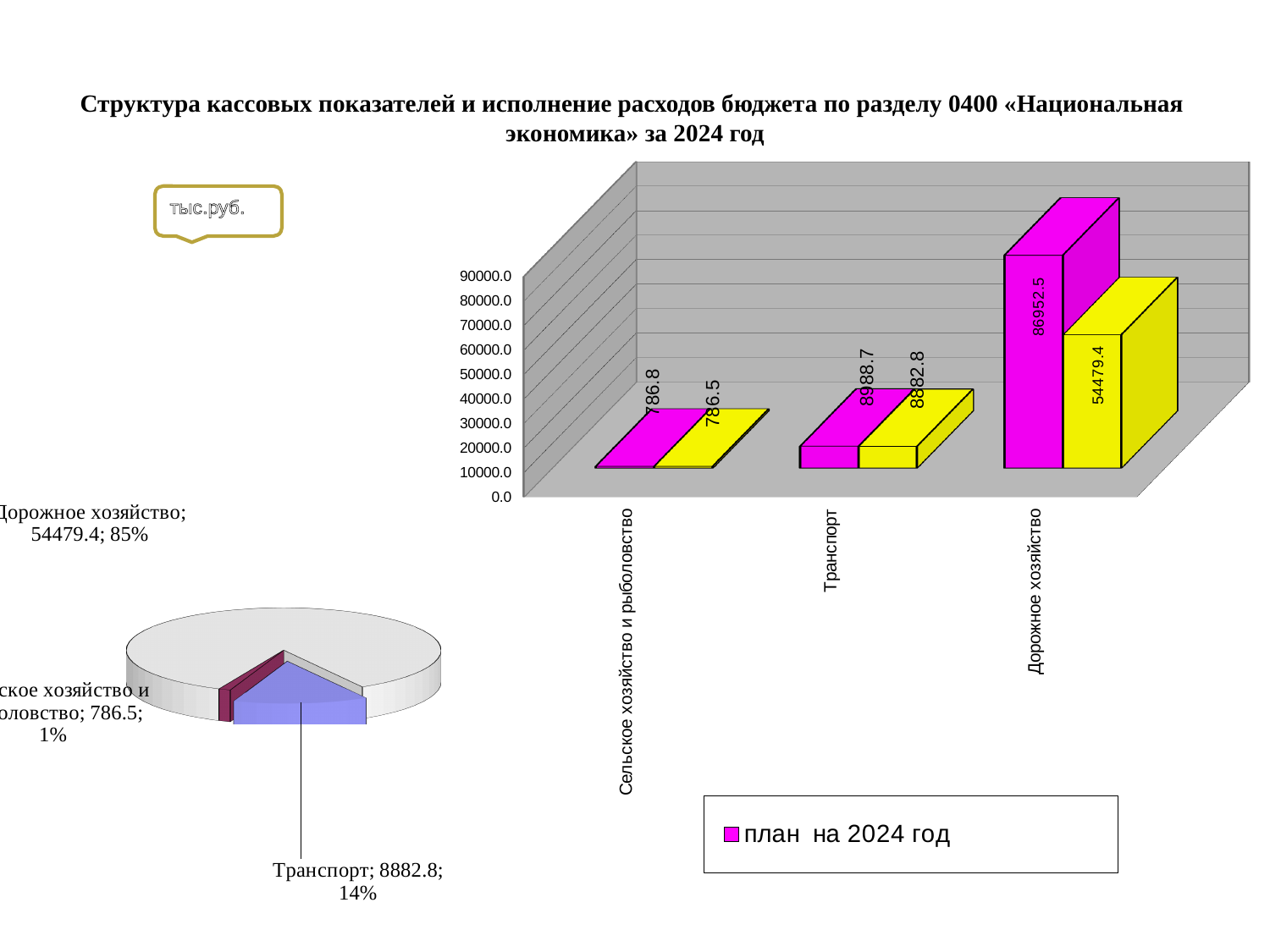
How many series does the legend of the bar chart list? 1 What kind of chart is the chart on the right of the slide? bar chart In the bar chart, what is the value of the yellow bar for Сельское хозяйство и рыболовство? 786.5 How many categories are shown on the x axis of the bar chart? 3 In the pie chart, what share does Транспорт have? 14% In the bar chart, what is the difference between the план на 2024 год value and the yellow bar value for Дорожное хозяйство? 32473.1 In the bar chart, which category has the highest value for план на 2024 год? Дорожное хозяйство In the bar chart, what is the value of the yellow bar for Дорожное хозяйство? 54479.4 In the bar chart, what is the value of план на 2024 год for Дорожное хозяйство? 86952.5 In the bar chart, what is the value of план на 2024 год for Транспорт? 8988.7 In the bar chart, which is larger for Транспорт: the план на 2024 год bar or the yellow bar? план на 2024 год In the bar chart, which category has the lowest value for план на 2024 год? Сельское хозяйство и рыболовство